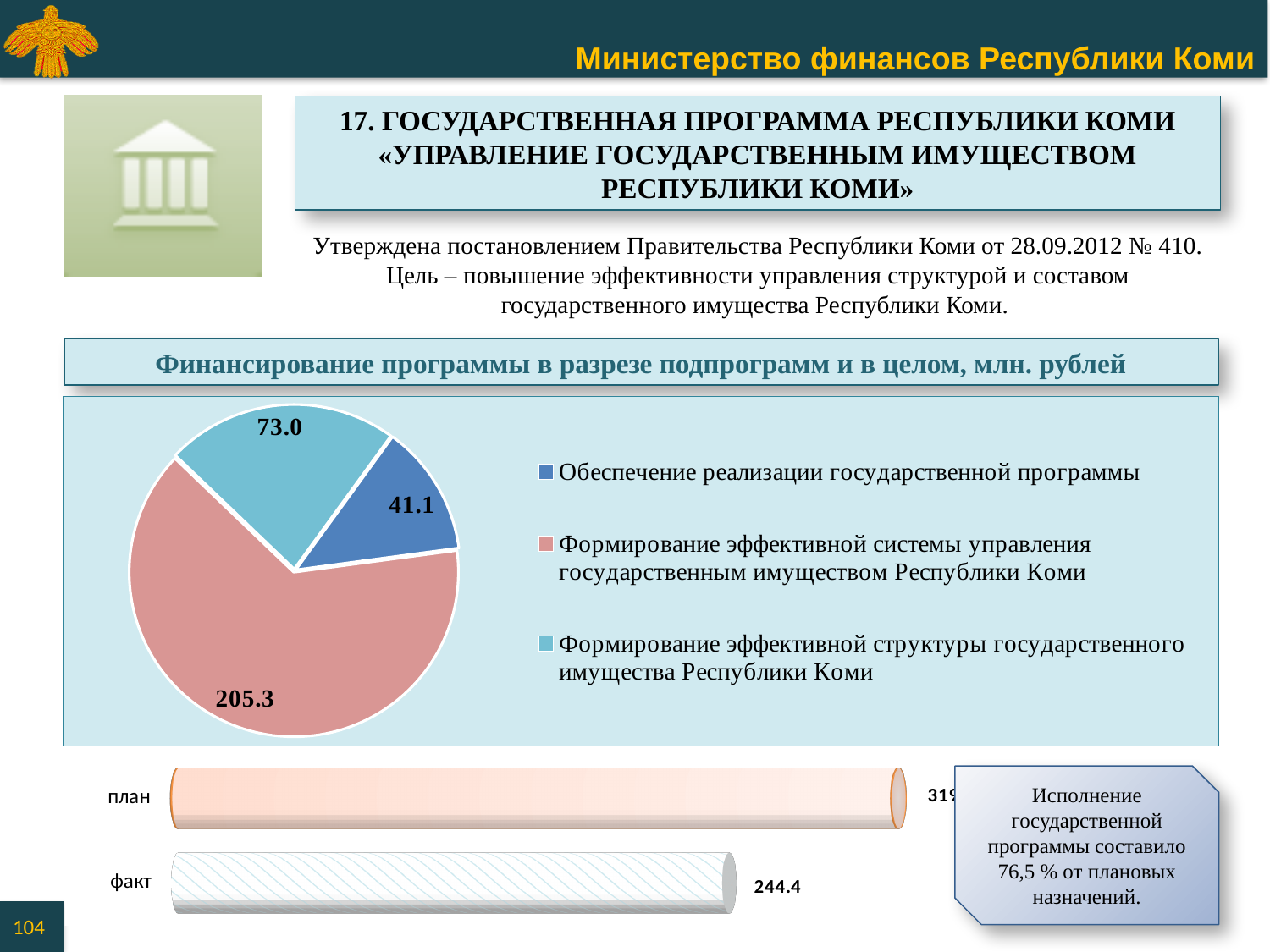
In the pie chart, what is the value for 'Формирование эффективной системы управления государственным имуществом Республики Коми'? 205.3 In the pie chart, what is the difference between the value for 'Формирование эффективной структуры государственного имущества Республики Коми' and the value for 'Обеспечение реализации государственной программы'? 31.9 In the pie chart, what is the difference between the value for 'Формирование эффективной системы управления государственным имуществом Республики Коми' and the value for 'Формирование эффективной структуры государственного имущества Республики Коми'? 132.3 What kind of chart is the upper chart on the slide (under the heading 'Финансирование программы в разрезе подпрограмм и в целом, млн. рублей')? pie chart In the bar chart at the bottom of the slide, which bar is longer, 'план' or 'факт'? план In the pie chart, what colour is the slice for 'Обеспечение реализации государственной программы'? dark blue In the pie chart, what is the value for 'Формирование эффективной структуры государственного имущества Республики Коми'? 73.0 In the pie chart, what is the value for 'Обеспечение реализации государственной программы'? 41.1 How many slices does the pie chart have? 3 In the pie chart, which subprogram has the largest slice? Формирование эффективной системы управления государственным имуществом Республики Коми In the pie chart, which subprogram has the smallest slice? Обеспечение реализации государственной программы In the bar chart at the bottom of the slide, what is the value for 'факт'? 244.4